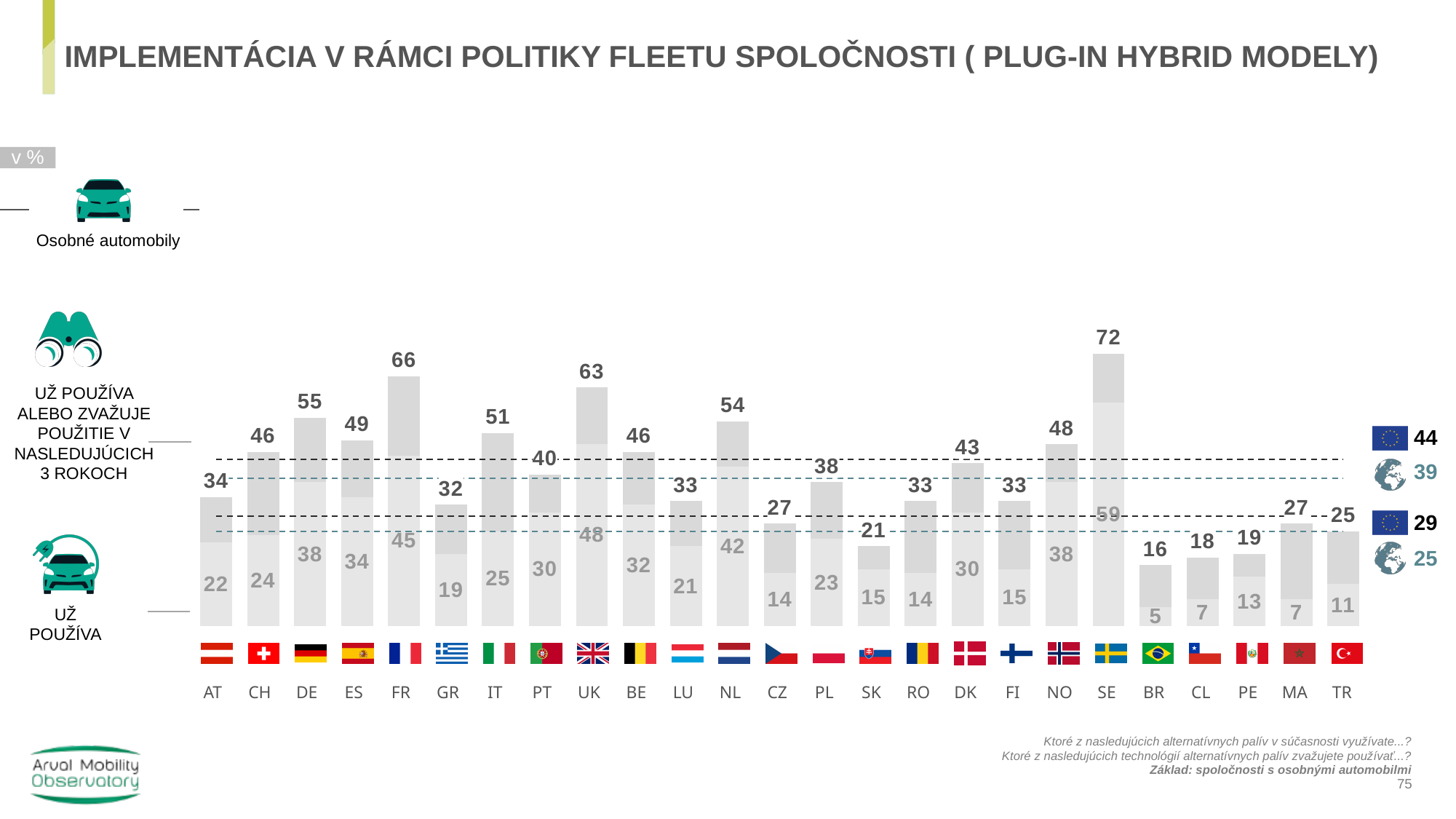
What is the 'už používa' value for SE? 59 How many countries are shown along the x axis of the chart? 25 What is the global reference value shown for 'už používa'? 25 Which country has the highest value for 'už používa alebo zvažuje použitie v nasledujúcich 3 rokoch'? SE What is the 'už používa alebo zvažuje' value for FR? 66 Which country has the lowest 'už používa' value? BR Which has a higher 'už používa alebo zvažuje' value, NL or IT? NL What is the 'už používa' value for UK? 48 What is the difference between the 'už používa alebo zvažuje' value and the 'už používa' value for DE? 17 What is the EU reference value shown for 'už používa alebo zvažuje použitie v nasledujúcich 3 rokoch'? 44 What type of chart is shown on the slide? bar chart Which country has the lowest value for 'už používa alebo zvažuje použitie v nasledujúcich 3 rokoch'? BR